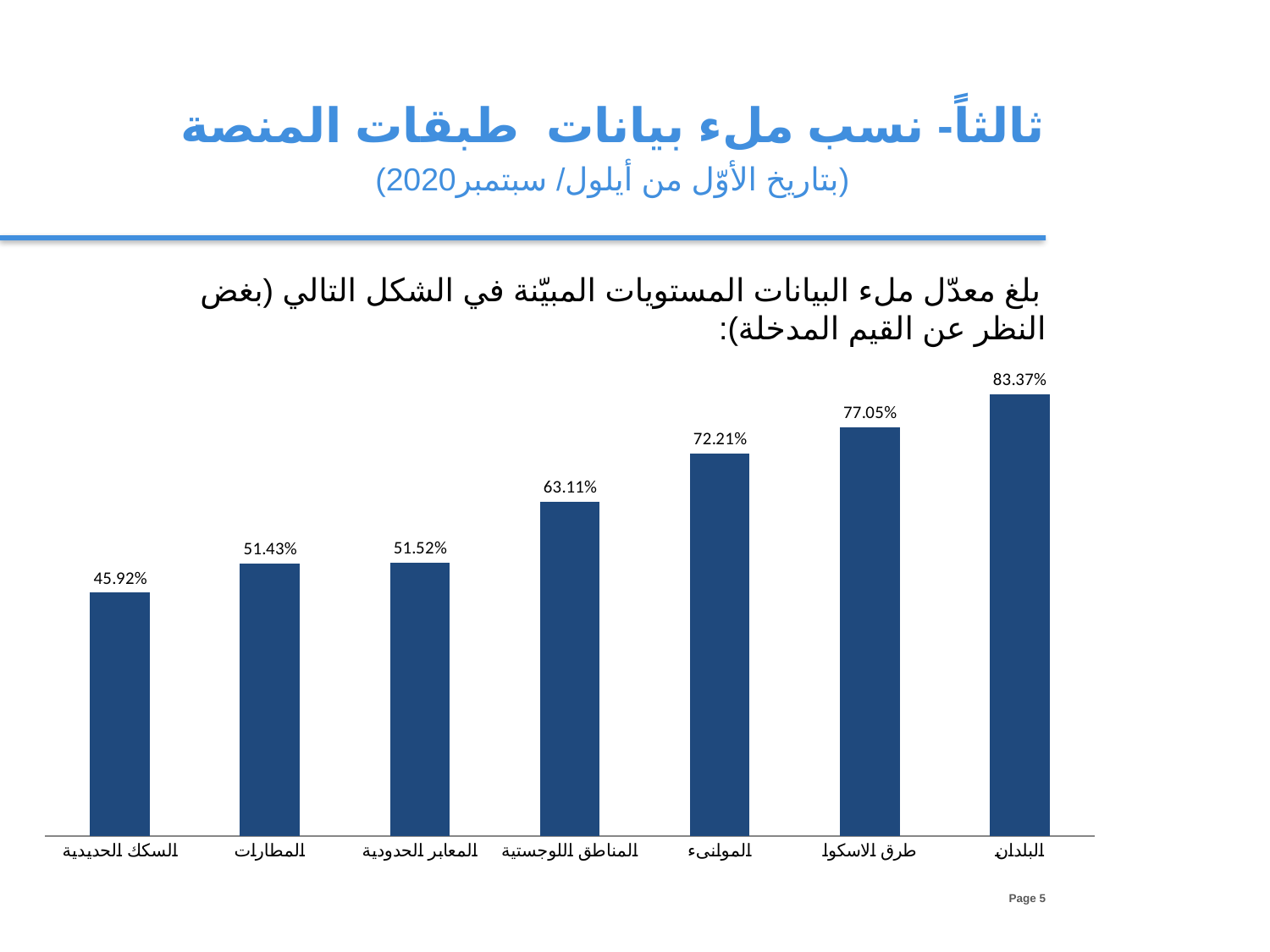
What kind of chart is shown on the slide? bar chart Which category has the highest value? البلدان What is the difference between the values for طرق الاسكوا and الموانئ? 4.84% What is the value for المناطق اللوجستية? 63.11% What is the value for السكك الحديدية? 45.92% Do the values rise or fall from left to right along the x axis? rise What is the difference between the values for البلدان and السكك الحديدية? 37.45% Which is larger, the value for المناطق اللوجستية or the value for المطارات? المناطق اللوجستية How many categories are shown in the chart? 7 What is the value for طرق الاسكوا? 77.05% Which category has the lowest value? السكك الحديدية What is the value for الموانئ? 72.21%